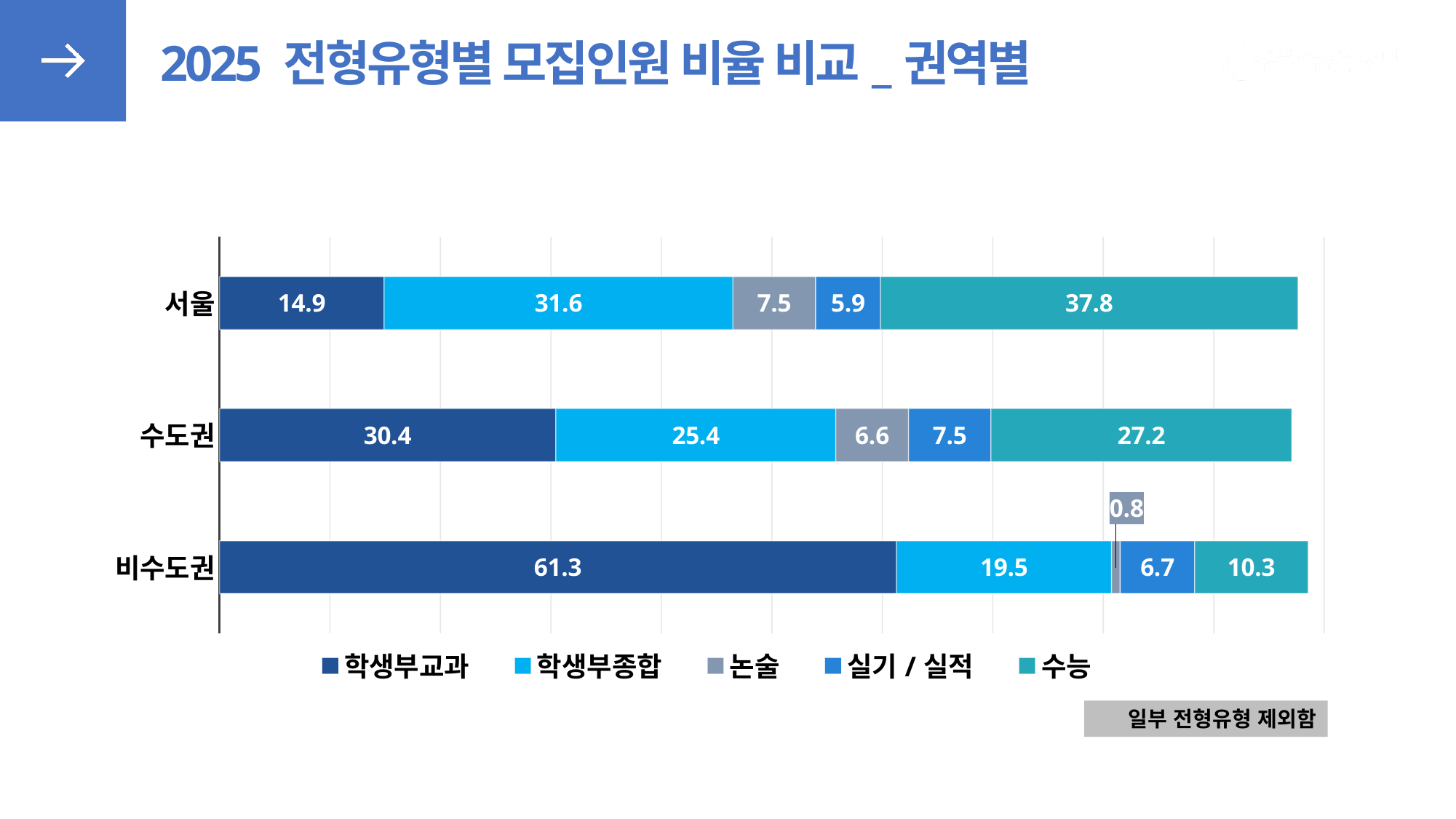
What is the value for 실기 / 실적 in 비수도권? 6.7 How many series does the legend list? 5 What is the value for 수능 in 비수도권? 10.3 Which region has the lowest value for 수능? 비수도권 What is the total of the stacked bar for 서울? 97.7 What is the value for 학생부교과 in 서울? 14.9 What is the difference between the 학생부종합 values for 서울 and 비수도권? 12.1 Which is larger, the 수능 value for 서울 or for 수도권? 서울 Which region has the highest value for 학생부교과? 비수도권 What is the value for 논술 in 수도권? 6.6 What kind of chart is shown on the slide? Stacked bar chart How many regions are shown on the chart? 3